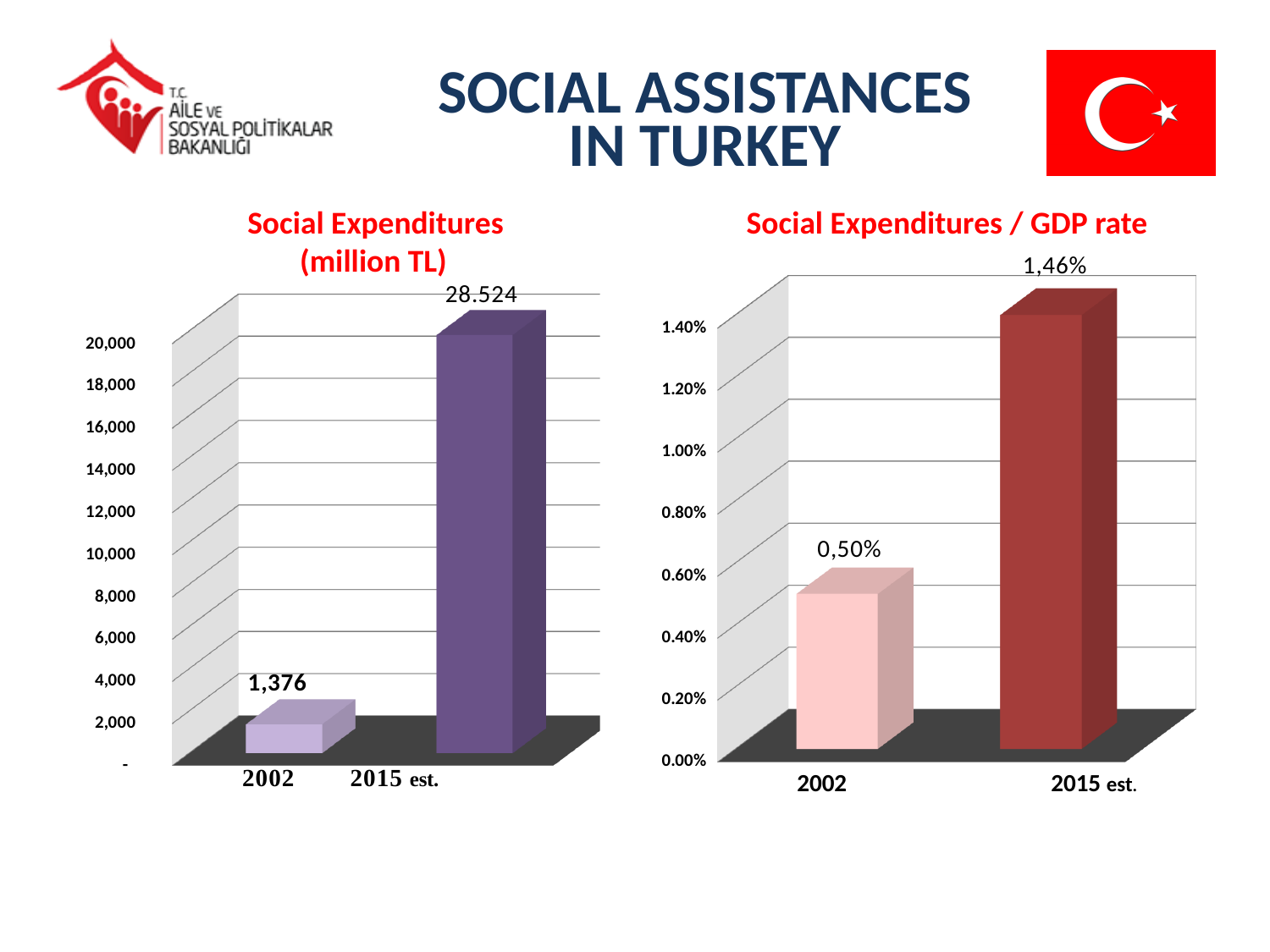
In the Social Expenditures / GDP rate chart, what is the value for 2002? 0,50% In the Social Expenditures / GDP rate chart, what is the difference between the 2015 est. value and the 2002 value? 0,96% In the Social Expenditures / GDP rate chart, which year has the highest value? 2015 est. In the Social Expenditures / GDP rate chart, is the value for 2002 greater or less than 0.60%? less In the Social Expenditures / GDP rate chart, do the values rise or fall from 2002 to 2015 est.? rise In the Social Expenditures (million TL) chart, what is the value for 2002? 1,376 How many categories are shown on the x axis of the Social Expenditures / GDP rate chart? 2 What kind of chart is the Social Expenditures (million TL) chart? bar chart In the Social Expenditures / GDP rate chart, what is the value for 2015 est.? 1,46% In the Social Expenditures (million TL) chart, which is larger, the value for 2002 or the value for 2015 est.? 2015 est. In the Social Expenditures (million TL) chart, which year has the lowest value? 2002 In the Social Expenditures (million TL) chart, what is the value for 2015 est.? 28.524